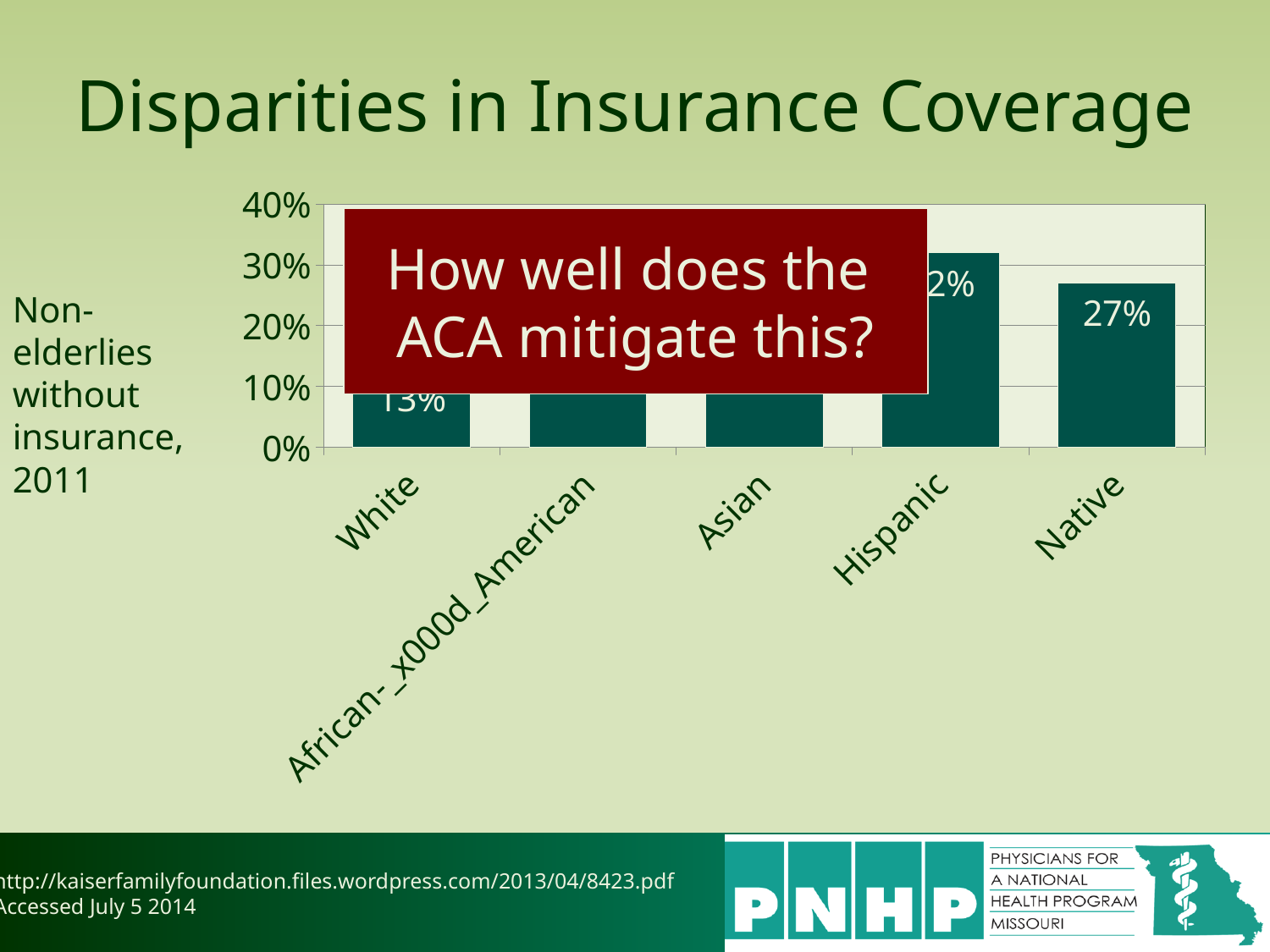
What is the difference between the values for Native and White? 14 percentage points Is the value for Native greater or less than 20%? greater Which is larger, the value for Hispanic or the value for Native? Hispanic Is the value for Native greater or less than 30%? less What is the value for Native? 27% What is the value for White? 13% Which is larger, the value for White or the value for Native? Native What is the title of the slide? Disparities in Insurance Coverage What does the red box overlaid on the chart say? How well does the ACA mitigate this? Is the value for Hispanic greater or less than 30%? greater What kind of chart is shown on the slide? bar chart How many categories are shown on the x axis? 5